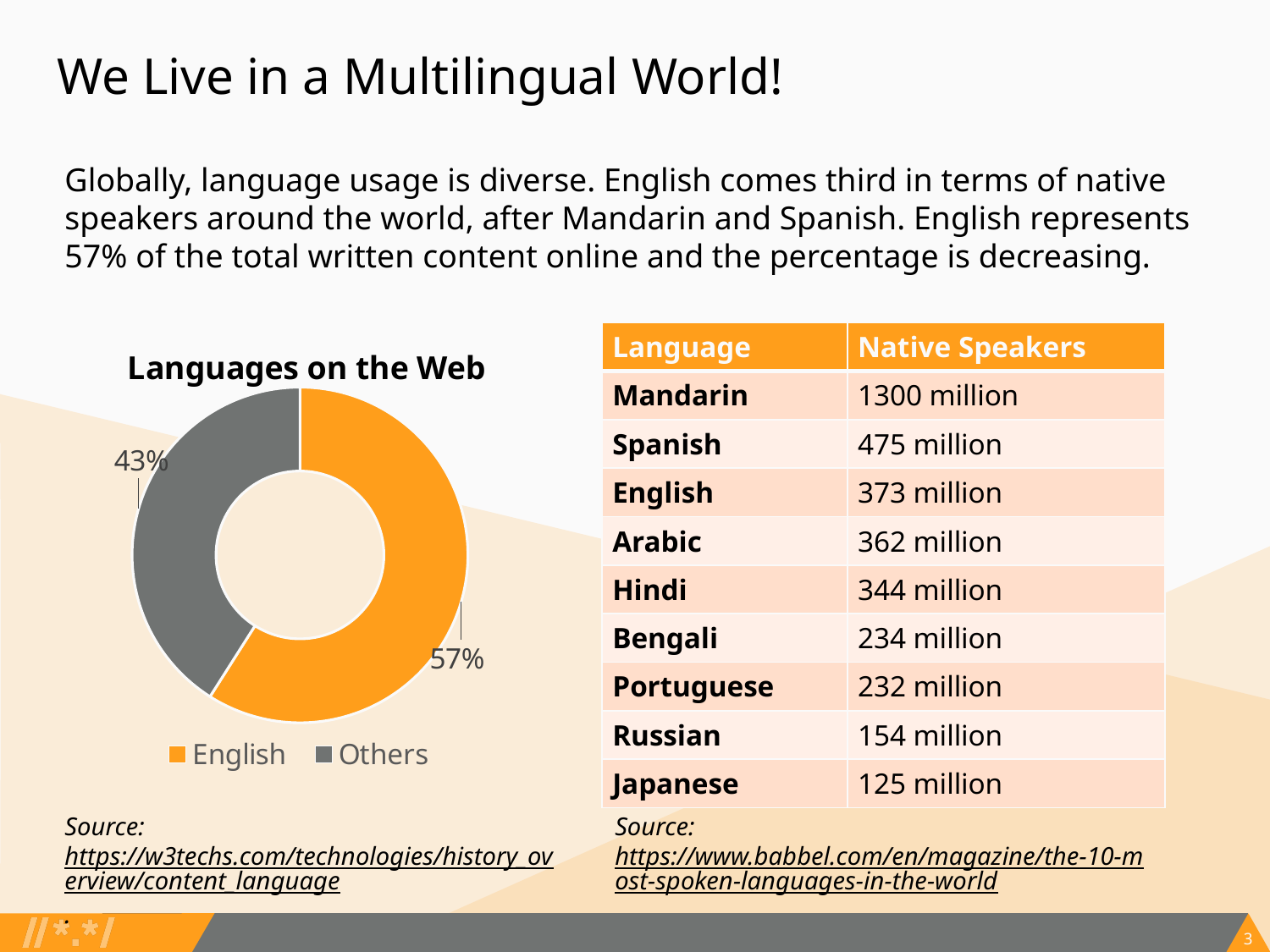
What kind of chart is "Languages on the Web"? Doughnut chart In the "Languages on the Web" chart, what is the combined share of English and Others? 100% Which category has the largest share in the "Languages on the Web" chart? English In the "Languages on the Web" chart, what is the difference between the English share and the Others share? 14% How many entries does the legend of the "Languages on the Web" chart list? 2 In the "Languages on the Web" chart, which is larger: the share for English or the share for Others? English Which category has the smallest share in the "Languages on the Web" chart? Others What is the title of the chart on the slide? Languages on the Web In the "Languages on the Web" chart, what colour represents English? Orange How many categories are shown in the "Languages on the Web" chart? 2 In the "Languages on the Web" chart, what share is shown for English? 57% In the "Languages on the Web" chart, what share is shown for Others? 43%